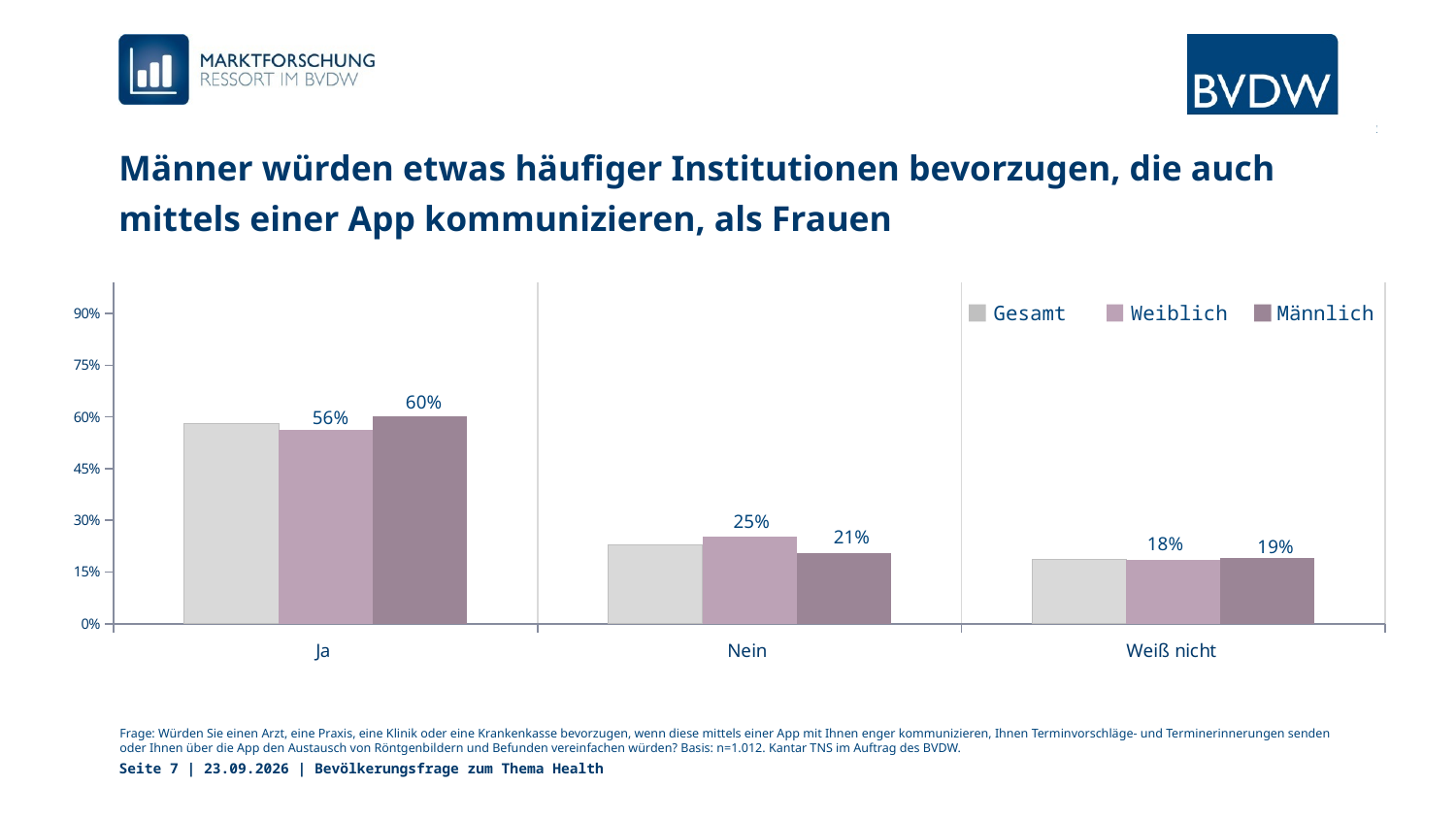
How many categories are shown on the x axis? 3 What is the difference between the Männlich and Weiblich values in the Ja category? 4% What is the value for Weiblich in the Nein category? 25% What is the value for Männlich in the Ja category? 60% Which category has the highest value for the Weiblich series? Ja What kind of chart is shown on the slide? bar chart What is the value for Weiblich in the Weiß nicht category? 18% What is the value for Männlich in the Nein category? 21% Is the value for Gesamt in the Ja category greater or less than 45%? greater Which category has the lowest value for the Männlich series? Weiß nicht In the Nein category, which is larger: the Weiblich value or the Männlich value? Weiblich How many series does the legend list? 3